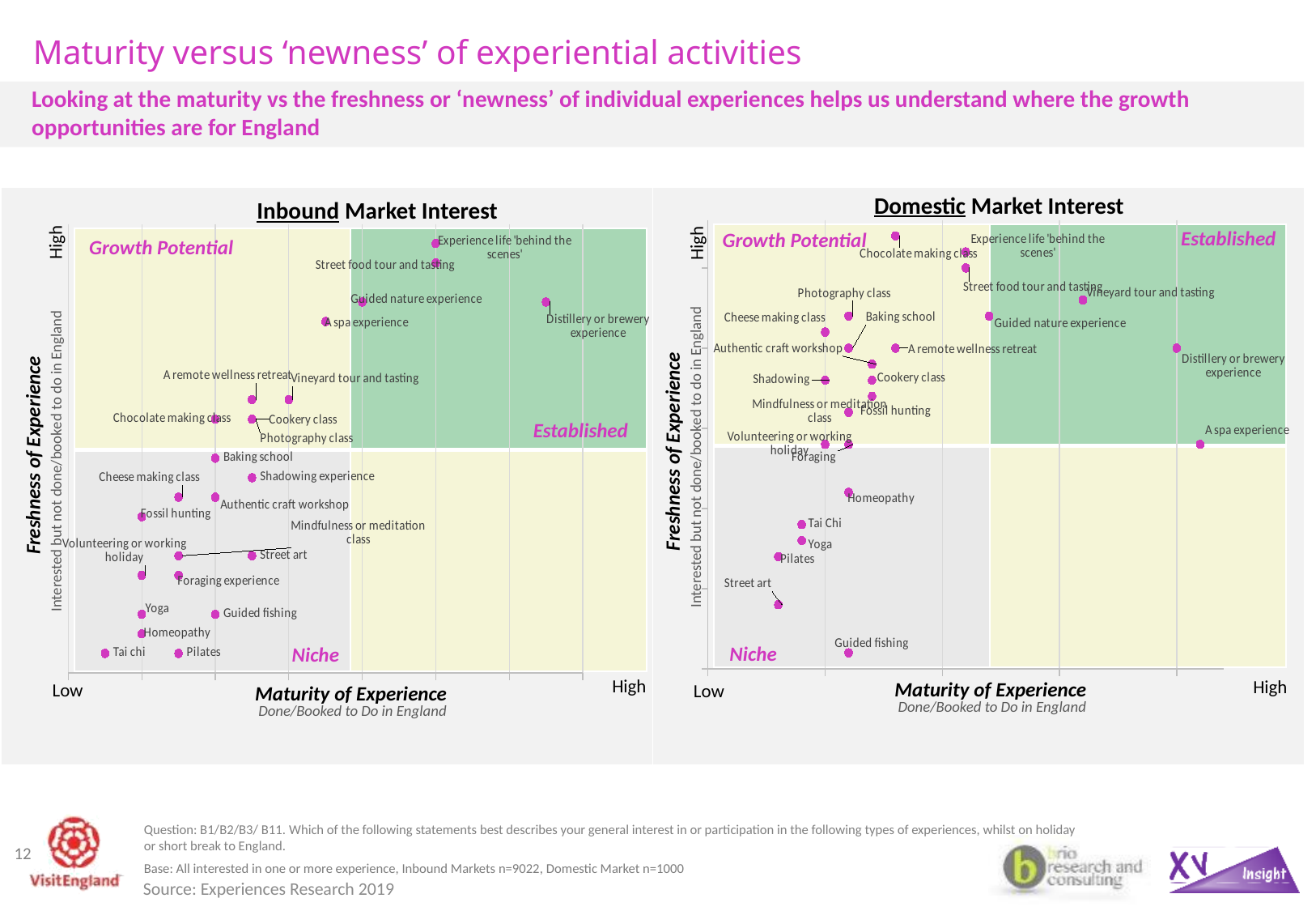
On the Inbound Market Interest chart, which experience is furthest right on the Maturity of Experience axis? Distillery or brewery experience On the Inbound Market Interest chart, which experience has the highest Freshness of Experience? Experience life 'behind the scenes' What are the three quadrant labels shown on the Inbound Market Interest chart? Growth Potential, Established, Niche What is the x-axis title of the Domestic Market Interest chart? Maturity of Experience On the Inbound Market Interest chart, which is more mature: Distillery or brewery experience or A spa experience? Distillery or brewery experience On the Domestic Market Interest chart, which experience is furthest right on the Maturity of Experience axis? A spa experience On the Domestic Market Interest chart, which has higher Freshness of Experience: Vineyard tour and tasting or A spa experience? Vineyard tour and tasting On the Domestic Market Interest chart, which quadrant does Distillery or brewery experience fall in? Established On the Inbound Market Interest chart, which experience is furthest left on the Maturity of Experience axis? Tai chi On the Inbound Market Interest chart, which quadrant does Yoga fall in? Niche What kind of chart is the Inbound Market Interest chart? Scatter chart On the Domestic Market Interest chart, which experience has the lowest Freshness of Experience? Guided fishing